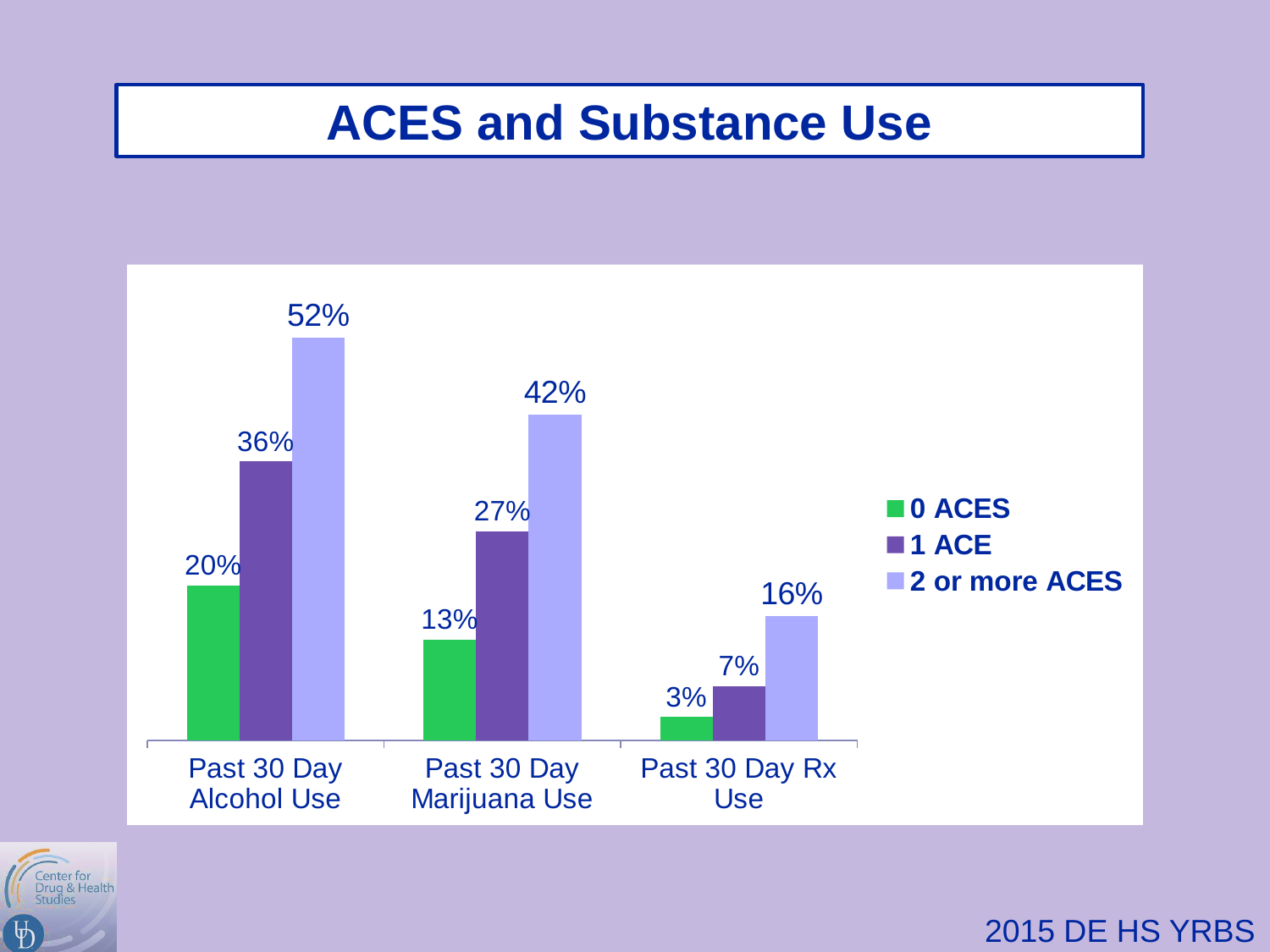
What is the difference between the 1 ACE and 0 ACES values for Past 30 Day Marijuana Use? 14% What is the value for 1 ACE for Past 30 Day Rx Use? 7% How many series does the legend list? 3 Which is larger: the 1 ACE value for Past 30 Day Alcohol Use or the 2 or more ACES value for Past 30 Day Rx Use? 1 ACE value for Past 30 Day Alcohol Use What is the title of the slide? ACES and Substance Use How many categories are shown on the x axis? 3 Which category has the lowest value for 0 ACES? Past 30 Day Rx Use Which category has the highest value for 2 or more ACES? Past 30 Day Alcohol Use What kind of chart is shown on the slide? Bar chart What is the difference between the 2 or more ACES and 0 ACES values for Past 30 Day Alcohol Use? 32% What is the value for 2 or more ACES for Past 30 Day Alcohol Use? 52% What is the value for 0 ACES for Past 30 Day Marijuana Use? 13%